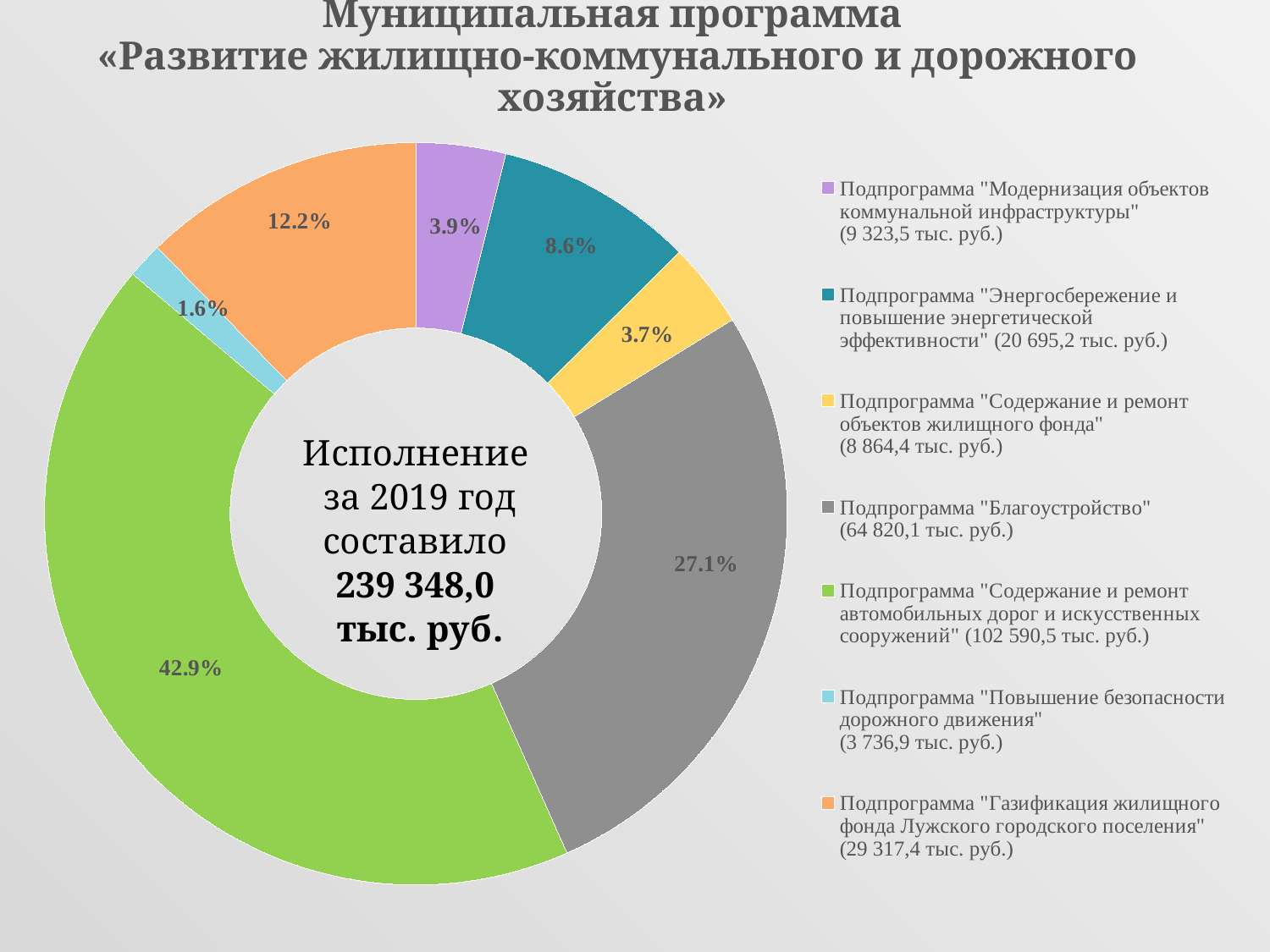
What total execution amount for 2019 is shown in the centre of the chart? 239 348,0 тыс. руб. What share of the pie does the subprogram "Содержание и ремонт автомобильных дорог и искусственных сооружений" account for? 42.9% What is the difference in percentage points between the shares of "Благоустройство" and "Газификация жилищного фонда Лужского городского поселения"? 14.9 Which subprogram has the largest share of the pie? Подпрограмма "Содержание и ремонт автомобильных дорог и искусственных сооружений" What kind of chart is shown on the slide? Doughnut (pie) chart Which has a larger share: "Модернизация объектов коммунальной инфраструктуры" or "Содержание и ремонт объектов жилищного фонда"? Подпрограмма "Модернизация объектов коммунальной инфраструктуры" What percentage is shown for the subprogram "Энергосбережение и повышение энергетической эффективности"? 8.6% What percentage is shown for the subprogram "Газификация жилищного фонда Лужского городского поселения"? 12.2% How many subprograms (slices) are shown in the chart? 7 According to the legend, what amount in тыс. руб. corresponds to the subprogram "Благоустройство"? 64 820,1 тыс. руб. What share of the pie does the subprogram "Благоустройство" account for? 27.1% Which subprogram has the smallest share of the pie? Подпрограмма "Повышение безопасности дорожного движения"